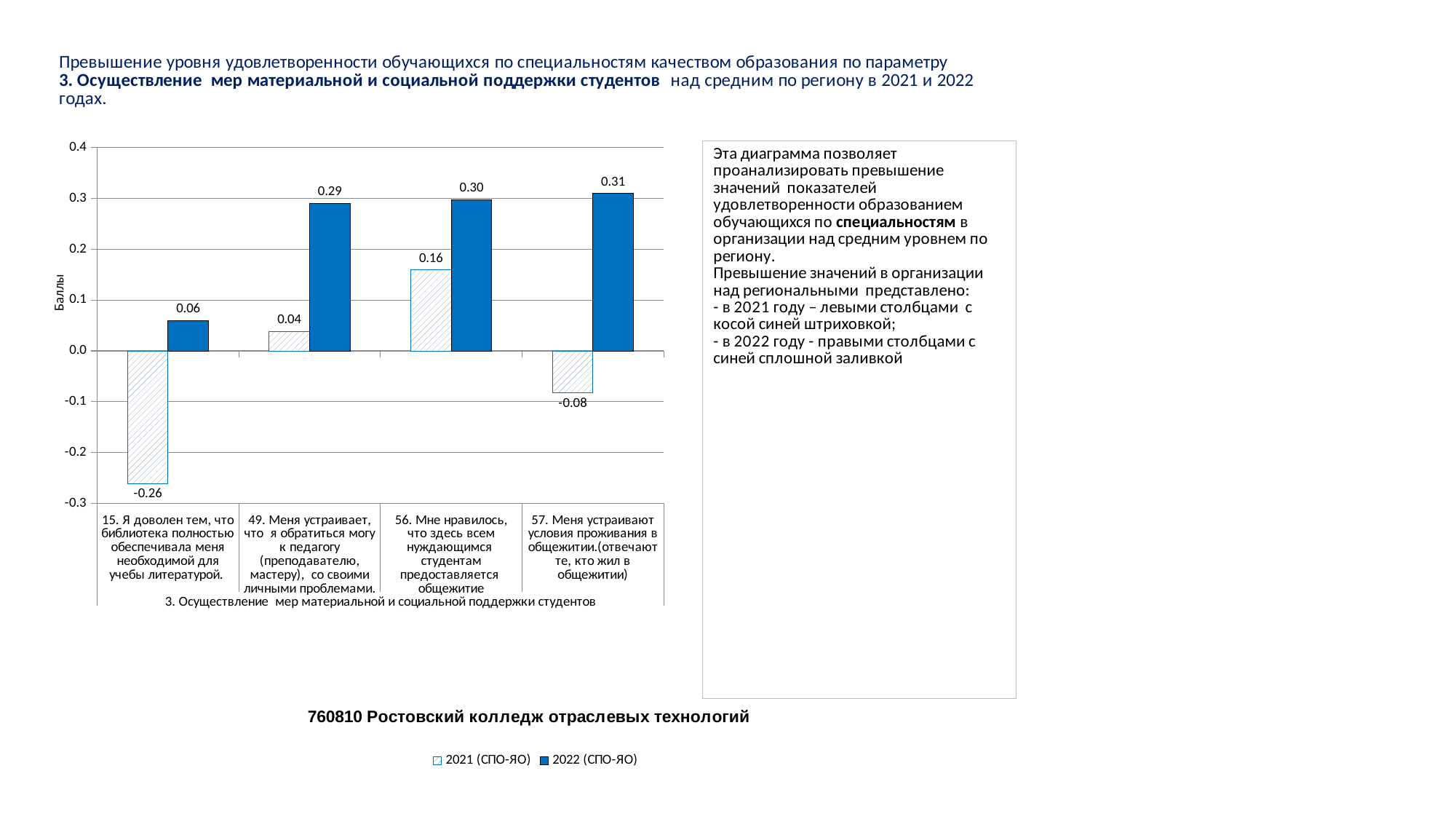
What is the 2021 (СПО-ЯО) value for item 15 (library provided necessary literature)? -0.26 What is the 2022 (СПО-ЯО) value for item 57 (living conditions in the dormitory)? 0.31 What is the 2021 (СПО-ЯО) value for item 56 (dormitory provided to all students in need)? 0.16 Which category has the highest 2022 (СПО-ЯО) value? 57. Меня устраивают условия проживания в общежитии How many categories are shown on the x axis? 4 Which category has the lowest 2021 (СПО-ЯО) value? 15. Я доволен тем, что библиотека полностью обеспечивала меня необходимой для учебы литературой. What is the difference between the 2022 and 2021 values for item 15? 0.32 For item 56, which series has the larger value, 2021 (СПО-ЯО) or 2022 (СПО-ЯО)? 2022 (СПО-ЯО) What kind of chart is shown on the slide? Bar chart How many series does the legend list? 2 What is the label of the vertical axis? Баллы What is the 2022 (СПО-ЯО) value for item 49 (can approach a teacher with personal problems)? 0.29